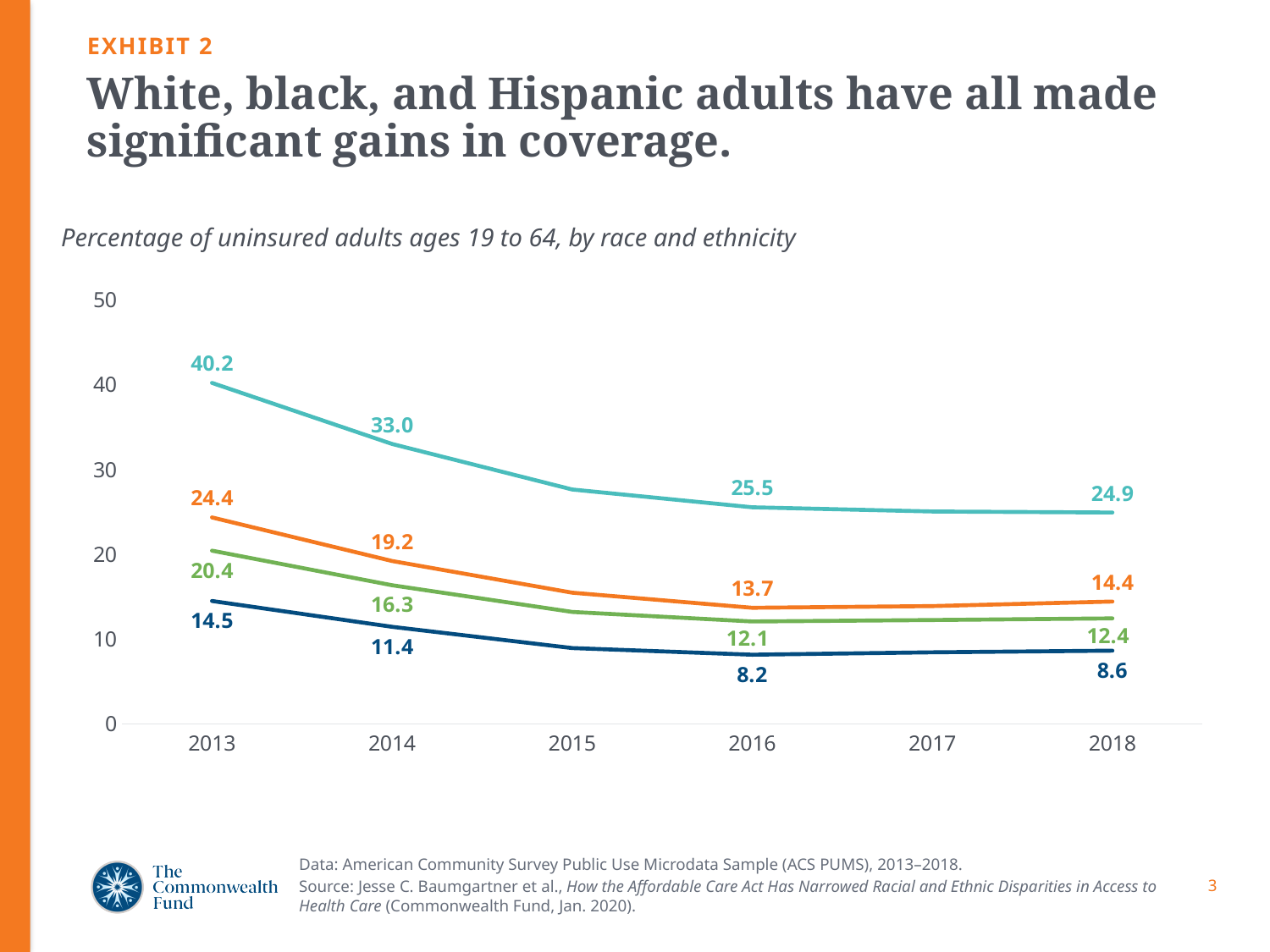
Which is larger in 2016, the orange line or the green line? orange line What is the value of the orange line in 2018? 14.4 How many lines are plotted on the chart? 4 In which year is the teal line at its highest? 2013 What is the value of the top (teal) line in 2013? 40.2 Does the teal line generally rise or fall from 2013 to 2018? fall What is the value of the green line in 2014? 16.3 In which labelled year is the dark blue line at its lowest? 2016 What kind of chart is shown on the slide? line chart What is the value of the bottom (dark blue) line in 2016? 8.2 How many years are shown along the x axis? 6 By how much did the teal line fall from 2013 to 2018? 15.3